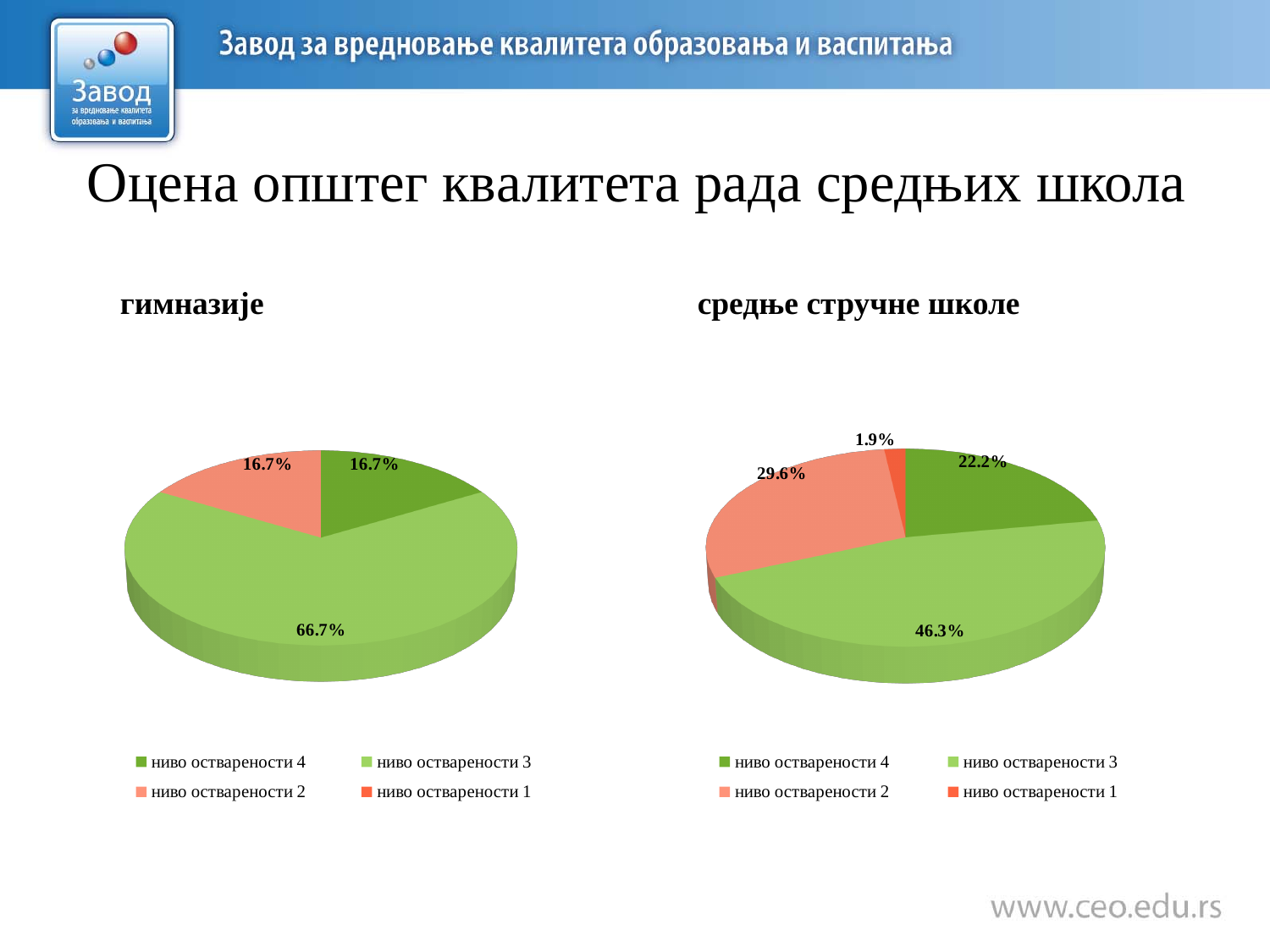
In the средње стручне школе chart, which is larger: the share for ниво остварености 4 or for ниво остварености 2? ниво остварености 2 In the средње стручне школе chart, what share is labelled for ниво остварености 1? 1.9% In the гимназије chart, which category has the largest slice? ниво остварености 3 In the гимназије chart, what share is labelled for ниво остварености 2? 16.7% In the средње стручне школе chart, what share is labelled for ниво остварености 2? 29.6% In the средње стручне школе chart, what share is labelled for ниво остварености 4? 22.2% In the средње стручне школе chart, what is the difference between the shares for ниво остварености 3 and ниво остварености 2? 16.7% How many entries does the legend of the средње стручне школе chart list? 4 In the гимназије chart, what share is labelled for ниво остварености 3? 66.7% In the средње стручне школе chart, which category has the smallest slice? ниво остварености 1 What type of chart is used for the гимназије data? pie chart In the средње стручне школе chart, which category has the largest slice? ниво остварености 3